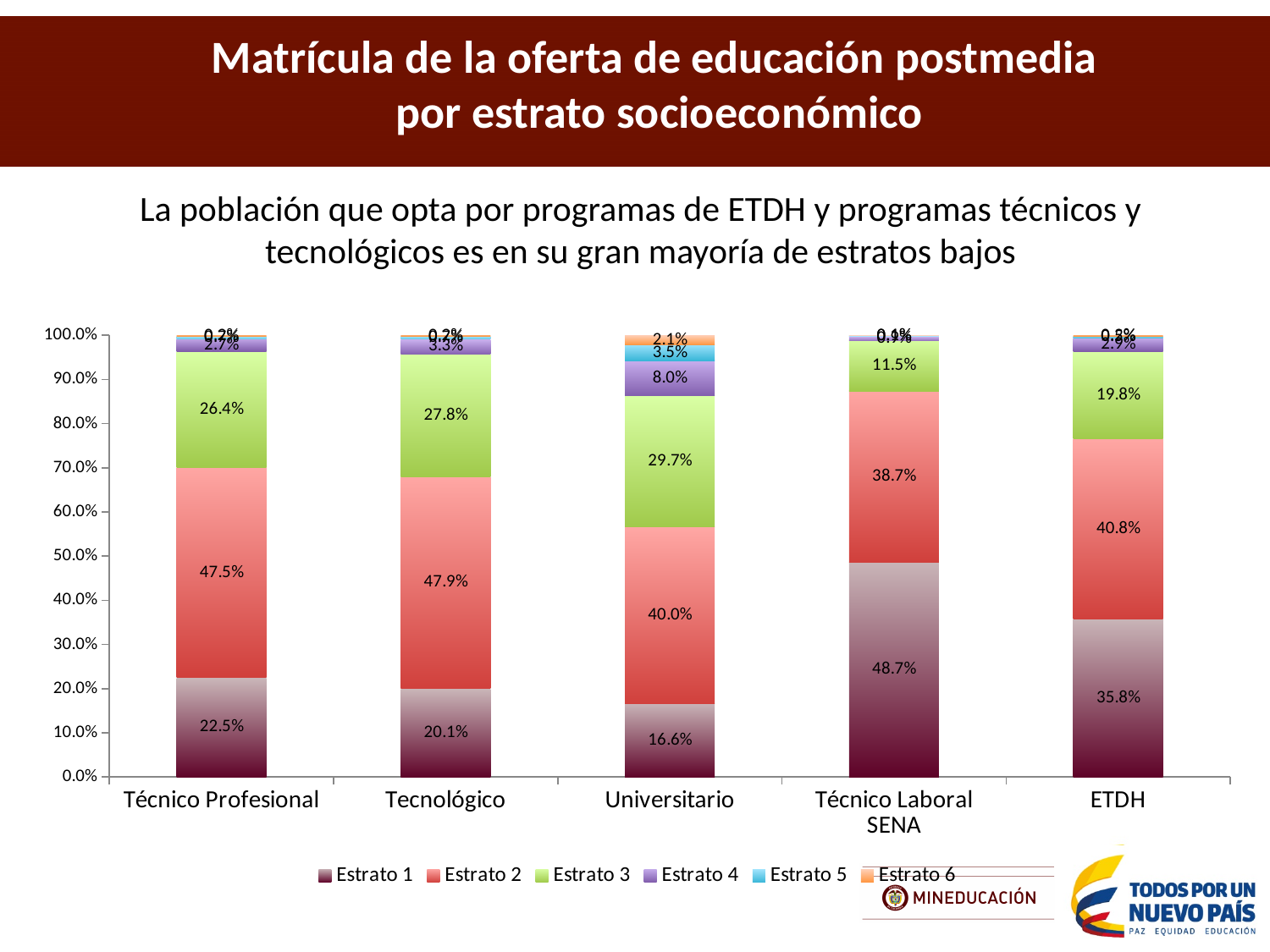
How many series does the legend list? 6 What is the Estrato 4 value for Universitario? 8.0% Which category has the lowest Estrato 3 value? Técnico Laboral SENA What is the difference between the Estrato 1 values for ETDH and Universitario? 19.2% How many categories are shown on the x axis of the chart? 5 Which category has the highest Estrato 1 value? Técnico Laboral SENA What is the Estrato 3 value for ETDH? 19.8% Which is larger, the Estrato 3 value for Tecnológico or for Técnico Profesional? Tecnológico What type of chart is shown on the slide? stacked bar chart What is the Estrato 5 value for Universitario? 3.5% What is the Estrato 2 value for Universitario? 40.0% What is the Estrato 1 value for Técnico Laboral SENA? 48.7%